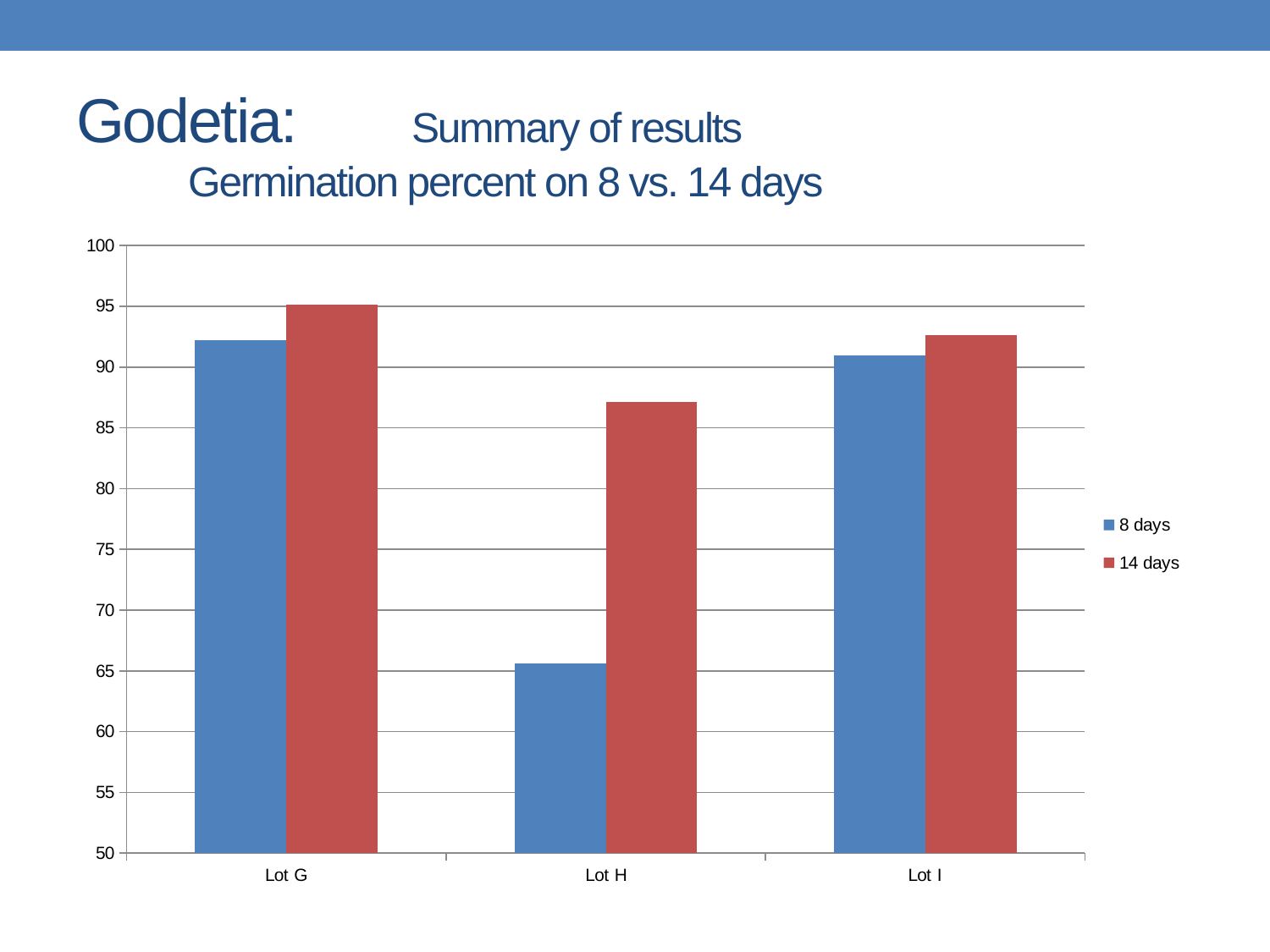
Is the 14 days value for Lot H greater or less than 85? greater What kind of chart is shown on the slide? bar chart Is the 8 days value for Lot H greater or less than 70? less Which lot has the lowest germination percent at 8 days? Lot H For Lot H, which is larger: the 8 days value or the 14 days value? 14 days Which is larger: the 8 days value for Lot G or the 8 days value for Lot H? Lot G Which colour represents the 14 days series in the chart? red How many lots are shown on the x axis of the chart? 3 Which lot has the highest germination percent at 14 days? Lot G Which lot has the lowest germination percent at 14 days? Lot H How many series does the chart's legend list? 2 Is the 14 days value for Lot G greater or less than 90? greater